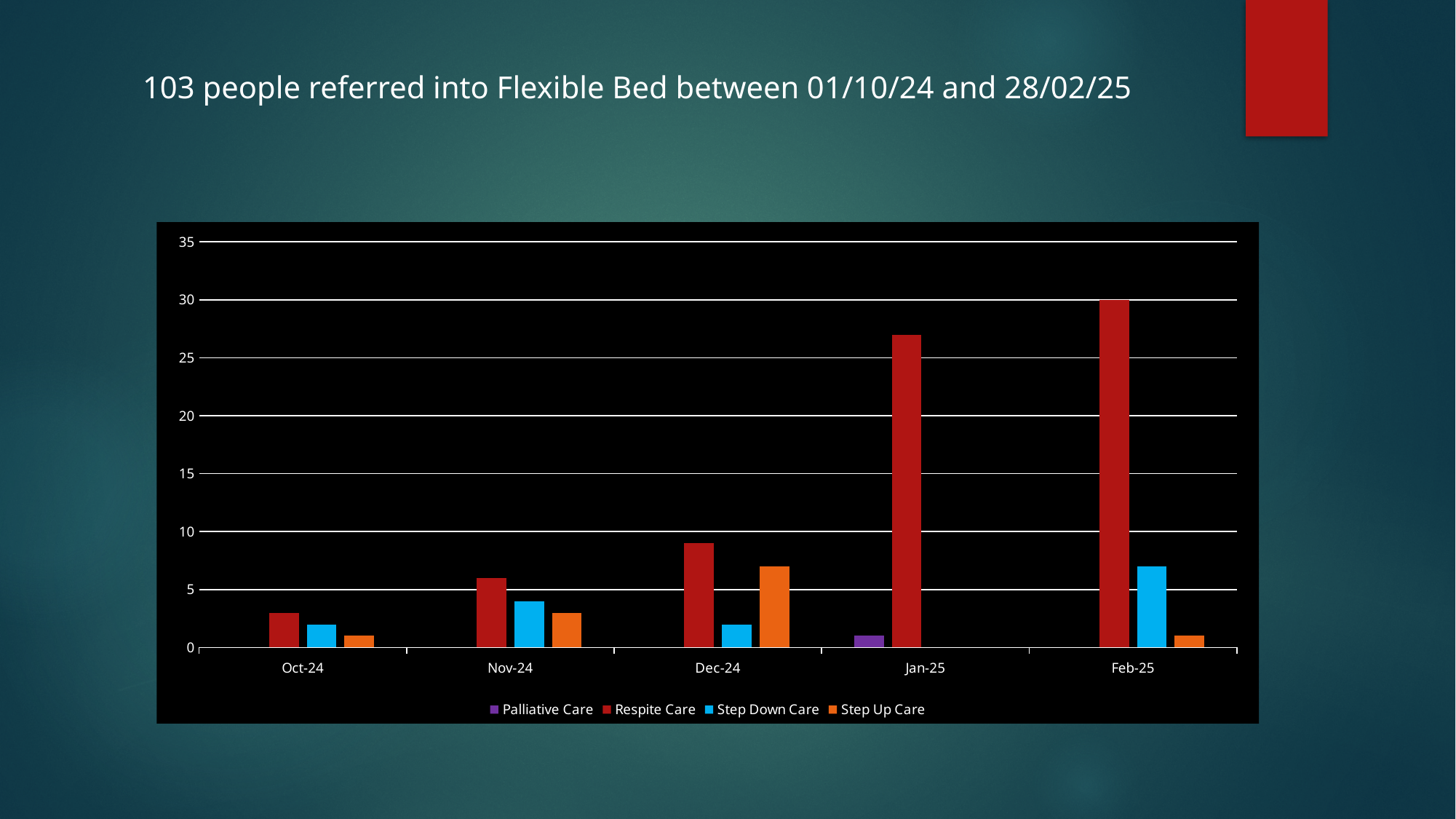
In Nov-24, which is larger: Respite Care or Step Down Care? Respite Care How many months are shown on the x axis? 5 Does the Respite Care value rise or fall from Oct-24 to Feb-25? rise What is the Respite Care value for Feb-25? 30 What kind of chart is shown on the slide? bar chart Is the Respite Care value for Dec-24 greater or less than 10? less In which month is the Respite Care value highest? Feb-25 Is the Respite Care value for Jan-25 greater or less than 25? greater Is the Step Down Care value for Feb-25 greater or less than 5? greater In Dec-24, which is larger: Step Up Care or Step Down Care? Step Up Care How many series does the legend list? 4 What colour represents Step Up Care in the legend? orange